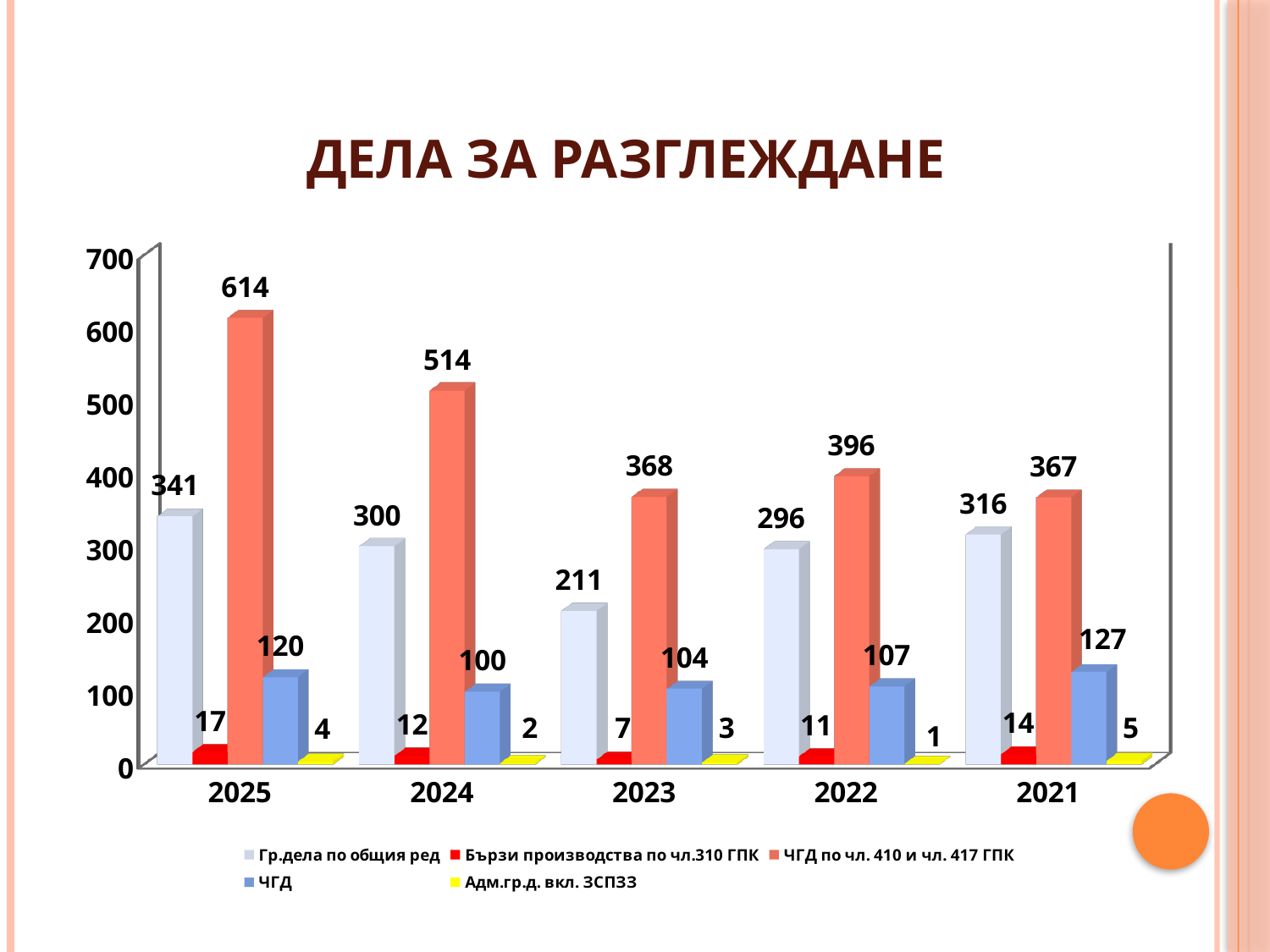
What kind of chart is shown on the slide? Bar chart Which is larger: the "Гр.дела по общия ред" value for 2022 or for 2021? 2021 How many years are shown on the x axis? 5 What is the title of the chart? ДЕЛА ЗА РАЗГЛЕЖДАНЕ How many series does the legend list? 5 What is the value for "Гр.дела по общия ред" in 2025? 341 What is the value for "Бързи производства по чл.310 ГПК" in 2022? 11 What is the difference between the "ЧГД по чл. 410 и чл. 417 ГПК" values for 2025 and 2024? 100 What is the value for "ЧГД по чл. 410 и чл. 417 ГПК" in 2023? 368 In which year is the value for "Гр.дела по общия ред" lowest? 2023 In which year is the value for "ЧГД по чл. 410 и чл. 417 ГПК" highest? 2025 What is the value for "ЧГД" in 2021? 127